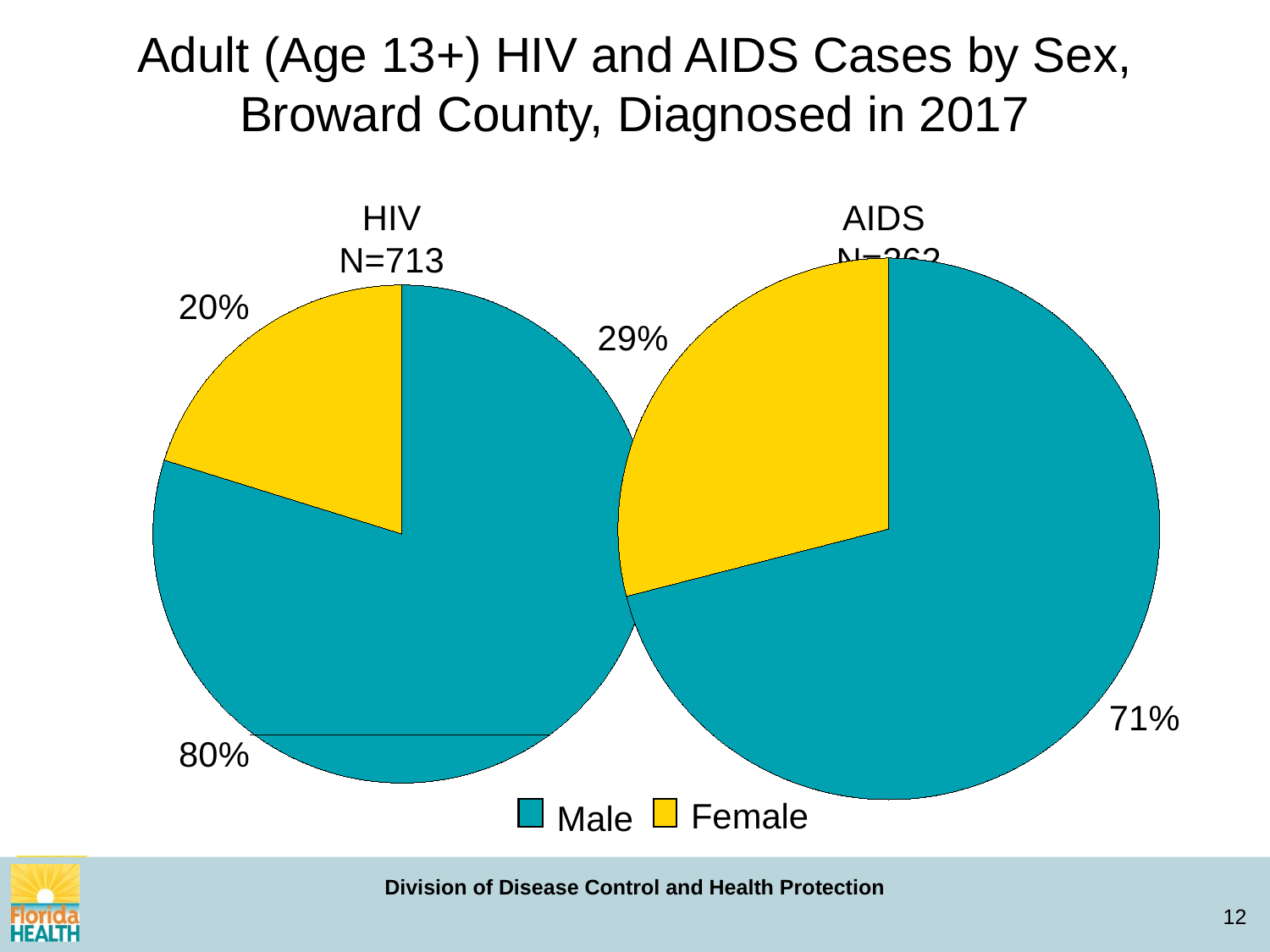
In the AIDS pie chart, which sex has the smaller share of cases? Female In the HIV pie chart, what percentage of cases are female? 20% In the HIV pie chart, what is the total number of cases (N) shown? N=713 How many categories does the legend list? 2 In the AIDS pie chart, what percentage of cases are female? 29% What is the difference between the male and female percentages in the AIDS pie chart? 42% In the AIDS pie chart, what percentage of cases are male? 71% What is the difference between the male and female percentages in the HIV pie chart? 60% In the HIV pie chart, what percentage of cases are male? 80% In the HIV pie chart, which sex has the larger share of cases? Male Is the female share larger in the HIV pie chart or the AIDS pie chart? AIDS What type of charts are shown on the slide? Pie charts